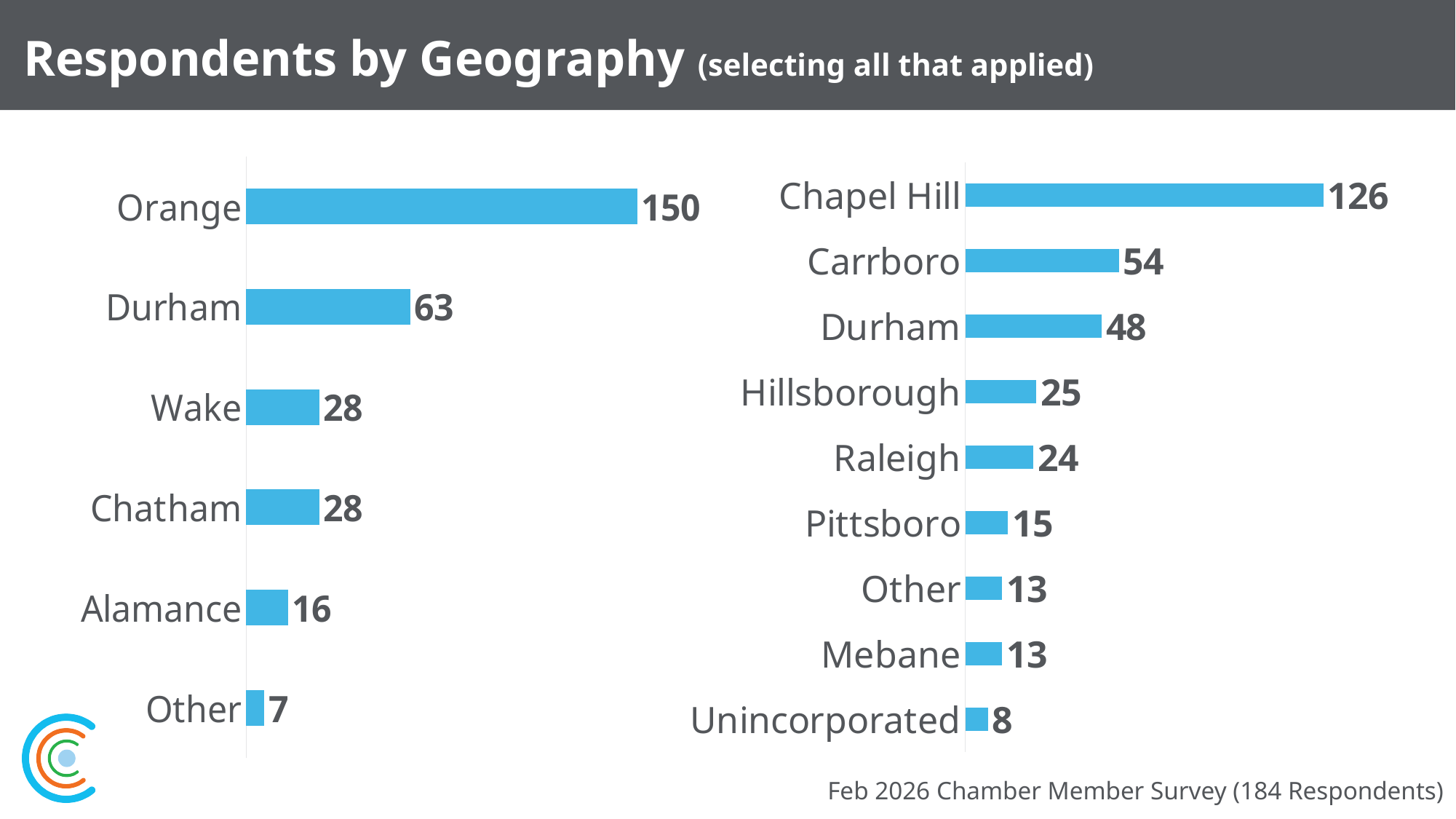
In the right chart, which is larger, Durham or Raleigh? Durham In the right chart, what is the value for Carrboro? 54 In the right chart, what is the difference between Chapel Hill and Carrboro? 72 What kind of chart is the right chart? Bar chart In the right chart, which category has the lowest value? Unincorporated How many categories are shown in the right chart? 9 In the left chart, which category has the highest value? Orange In the right chart, what is the value for Hillsborough? 25 How many categories are shown in the left chart? 6 In the left chart, what is the value for Orange? 150 In the left chart, what is the difference between Orange and Durham? 87 What is the title of the slide? Respondents by Geography (selecting all that applied)